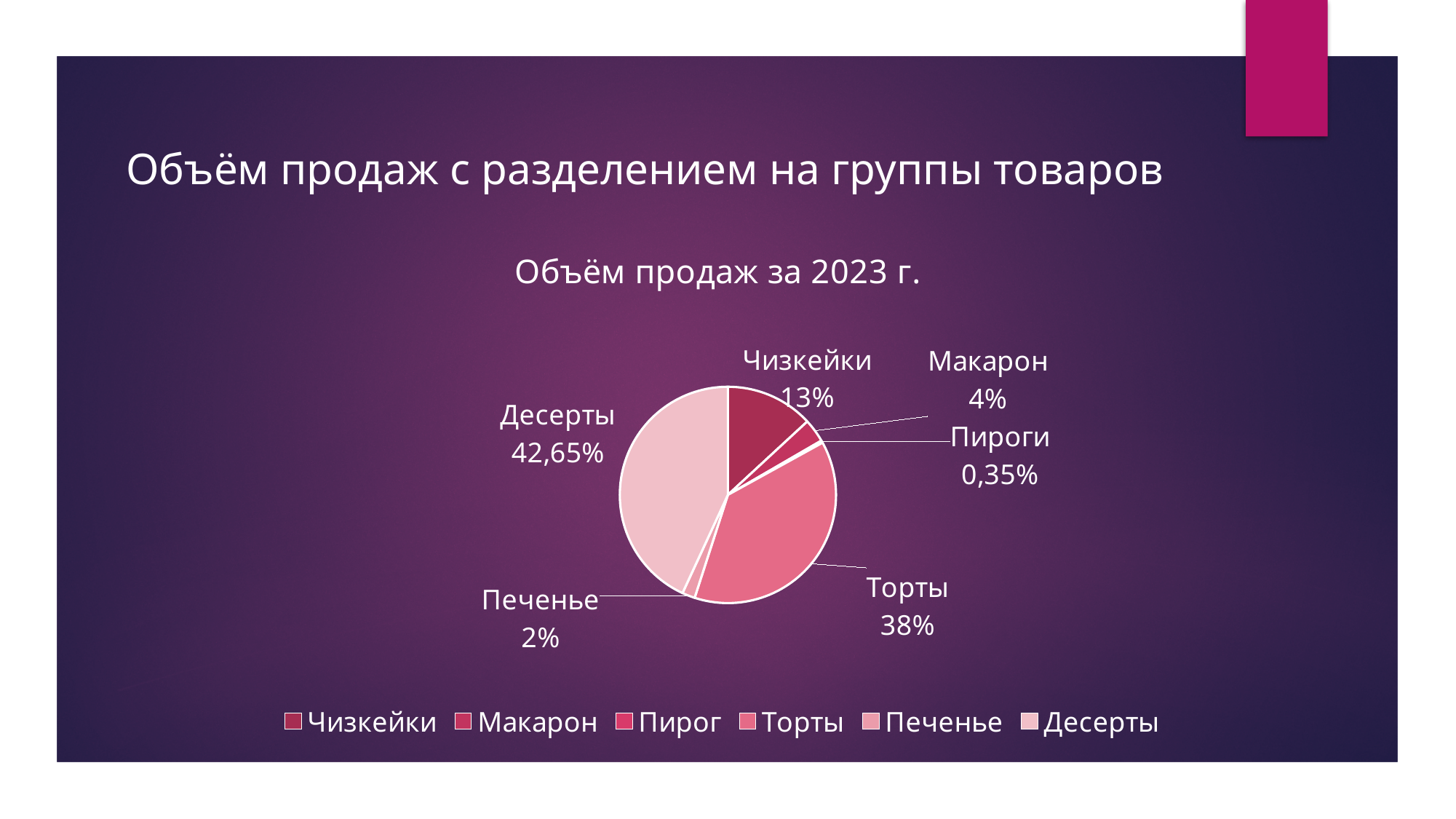
What share of sales do Пироги account for? 0,35% What is the difference in percentage points between Торты and Чизкейки? 25 What share of sales do Чизкейки account for? 13% What type of chart is shown on the slide? Pie chart How many entries does the legend list? 6 Which category has the largest share of sales? Десерты What share of sales do Десерты account for? 42,65% Which category has the smallest share of sales? Пироги Which has a larger share, Чизкейки or Макарон? Чизкейки What share of sales does Печенье account for? 2% What is the chart's title? Объём продаж за 2023 г. What share of sales do Торты account for? 38%